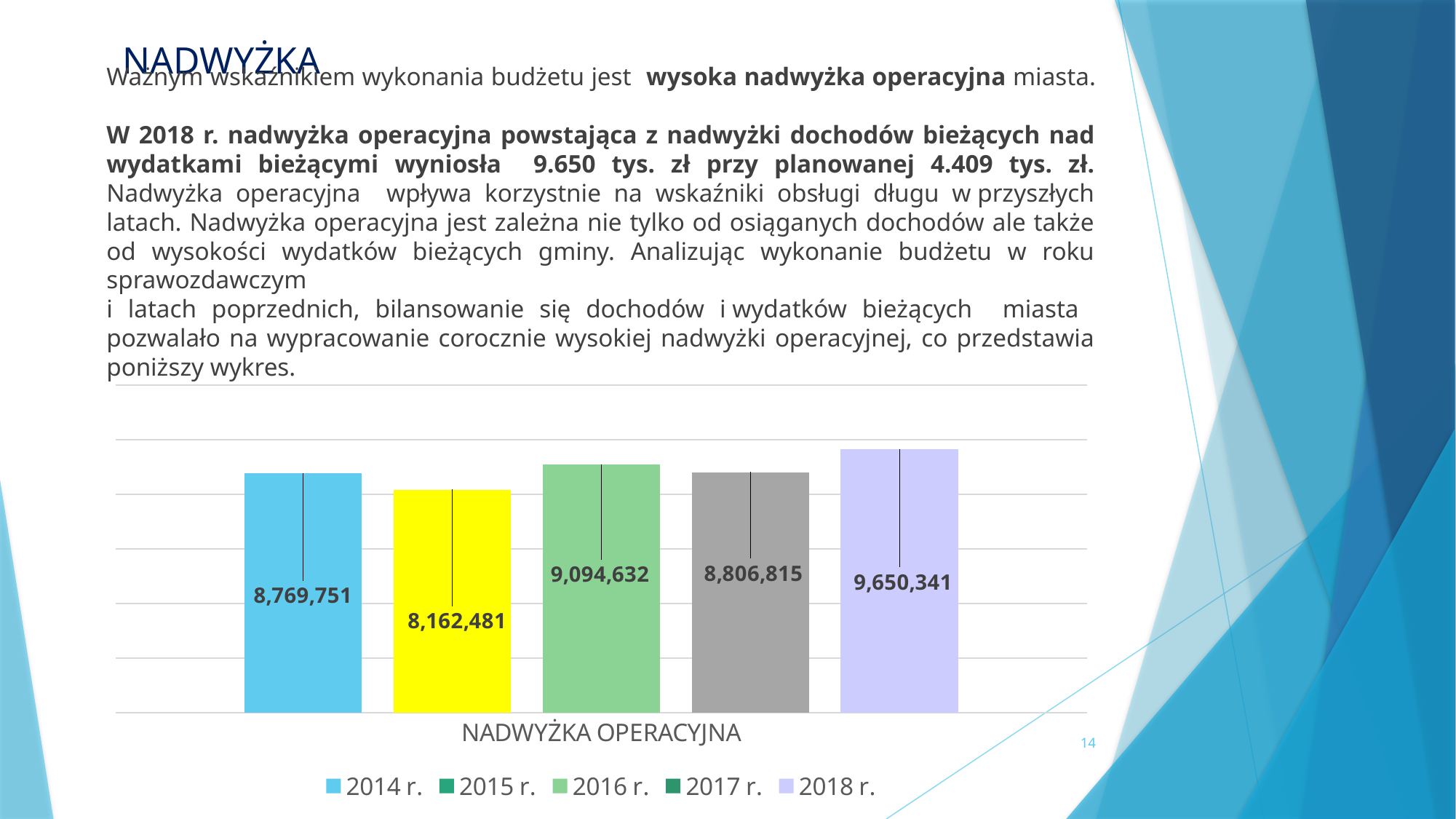
Which year has the highest operating surplus in the chart? 2018 r. How many series does the legend list? 5 What is the value of the operating surplus (nadwyżka operacyjna) for 2018 r.? 9,650,341 What type of chart is shown on the slide? bar chart What is the value shown for 2014 r.? 8,769,751 What is the value shown for 2016 r.? 9,094,632 What is the value shown for 2015 r.? 8,162,481 What is the category label shown below the bars? NADWYŻKA OPERACYJNA What is the difference between the values for 2016 r. and 2014 r.? 324,881 Which year has the lowest operating surplus in the chart? 2015 r. Which is larger, the value for 2016 r. or the value for 2017 r.? 2016 r. What is the difference between the values for 2018 r. and 2015 r.? 1,487,860